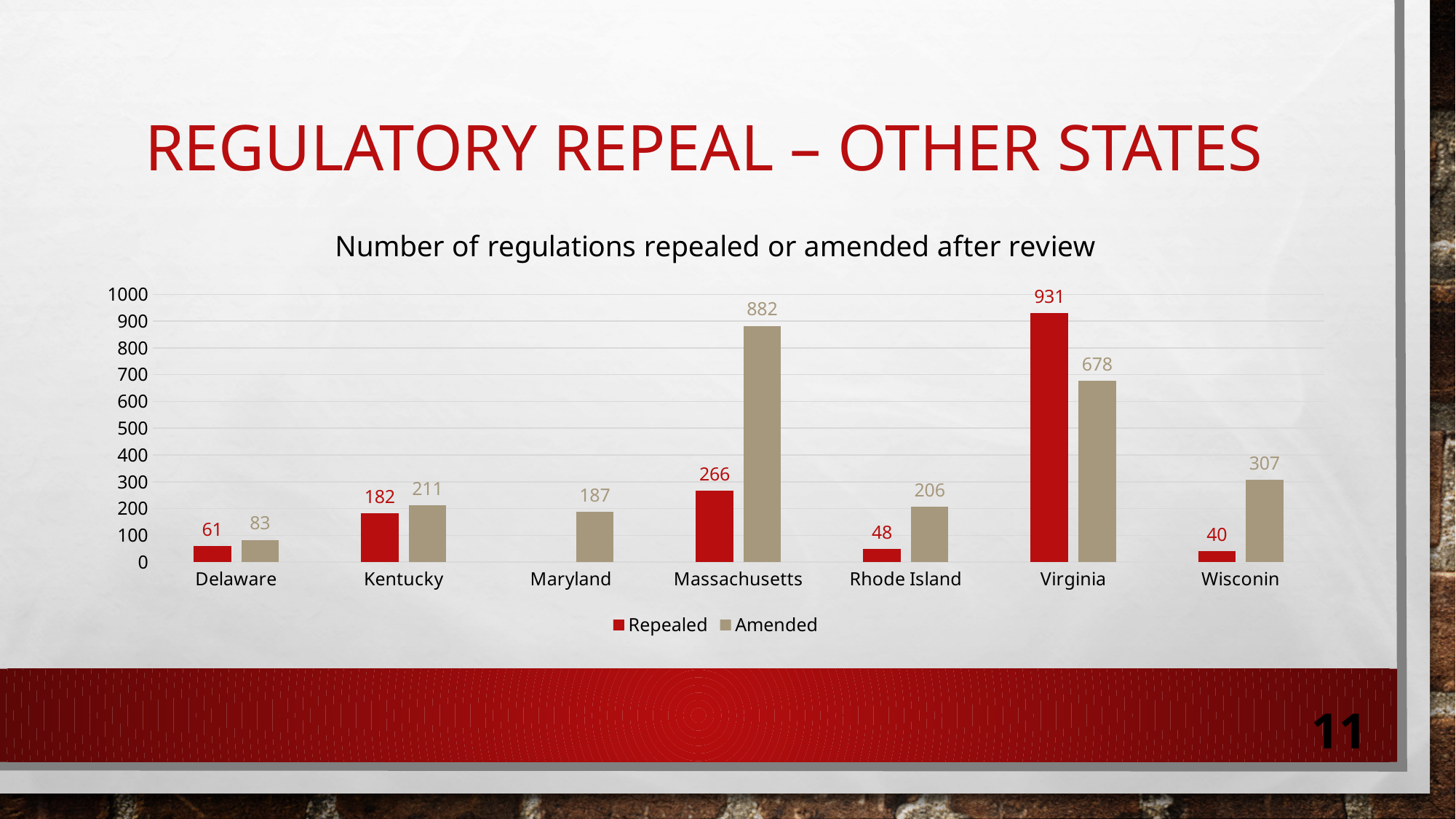
Which is larger for Virginia, the Repealed value or the Amended value? Repealed Which state has the highest Repealed value? Virginia Is the Amended value for Wisconin greater or less than 200? greater Which state has the lowest Repealed value among those with a Repealed bar? Wisconin What kind of chart is shown on the slide? Bar chart What is the difference between the Amended and Repealed values for Massachusetts? 616 How many regulations were amended in Massachusetts? 882 How many states are shown on the x axis? 7 What is the title of the chart? Number of regulations repealed or amended after review How many regulations were repealed in Virginia? 931 How many series does the legend list? 2 What is the Amended value for Maryland? 187